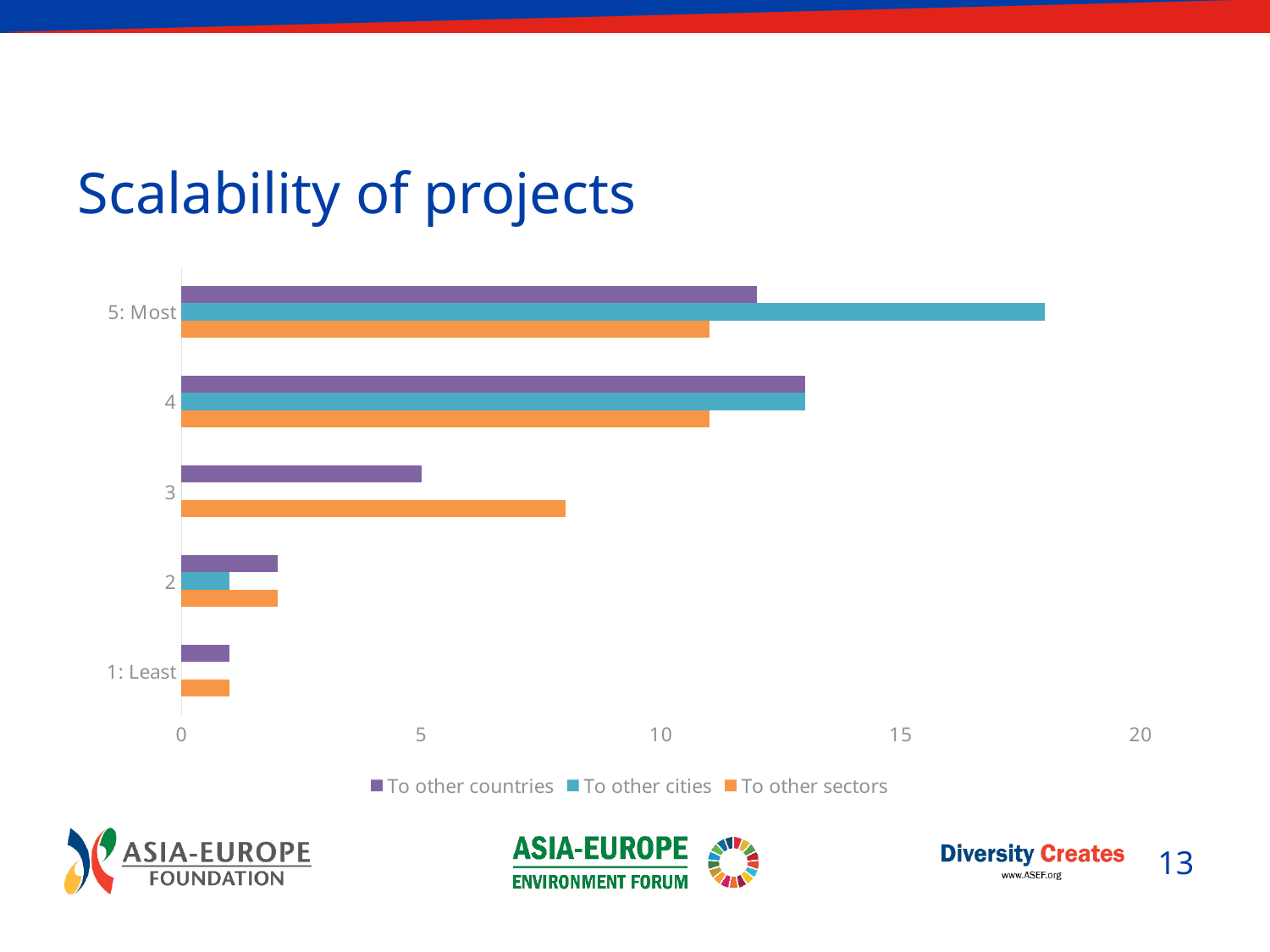
Is the 'To other sectors' value for '3' greater or less than 10? less For '5: Most', which is larger: 'To other cities' or 'To other countries'? To other cities What kind of chart is shown on the slide? bar chart How many rating categories are shown on the vertical axis? 5 Is the 'To other cities' value for '5: Most' greater or less than 15? greater Which category has the shortest 'To other countries' bar? 1: Least How many series does the legend list? 3 For category '3', which is larger: 'To other sectors' or 'To other countries'? To other sectors Is the 'To other countries' value for '4' greater or less than 10? greater What are the three series listed in the legend? To other countries, To other cities, To other sectors Which category has the longest 'To other cities' bar? 5: Most What is the title of the chart? Scalability of projects